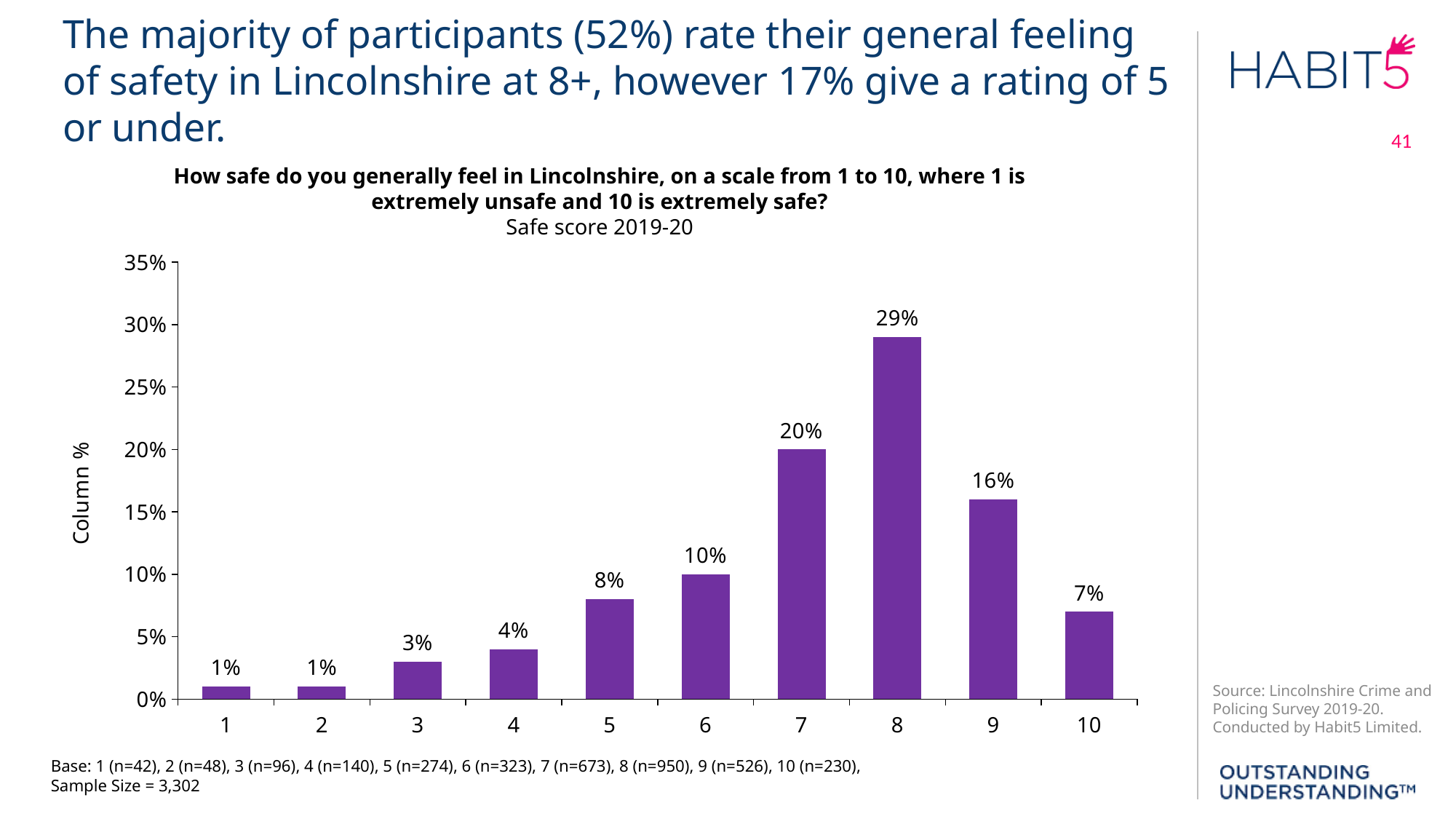
What percentage of participants gave a safe score of 10? 7% What is the label on the y axis of the chart? Column % Which has a higher percentage of participants, safe score 6 or safe score 9? 9 How many safe score categories are shown on the x axis? 10 What percentage of participants gave a safe score of 5? 8% What is the difference in percentage points between safe score 8 and safe score 7? 9% Do the values rise or fall from safe score 1 to safe score 8? Rise What percentage of participants gave a safe score of 8? 29% Is the value for safe score 7 greater or less than 15%? greater What is the difference in percentage points between safe score 9 and safe score 10? 9% What kind of chart is shown on the slide? Bar chart Which safe score has the highest percentage of participants? 8